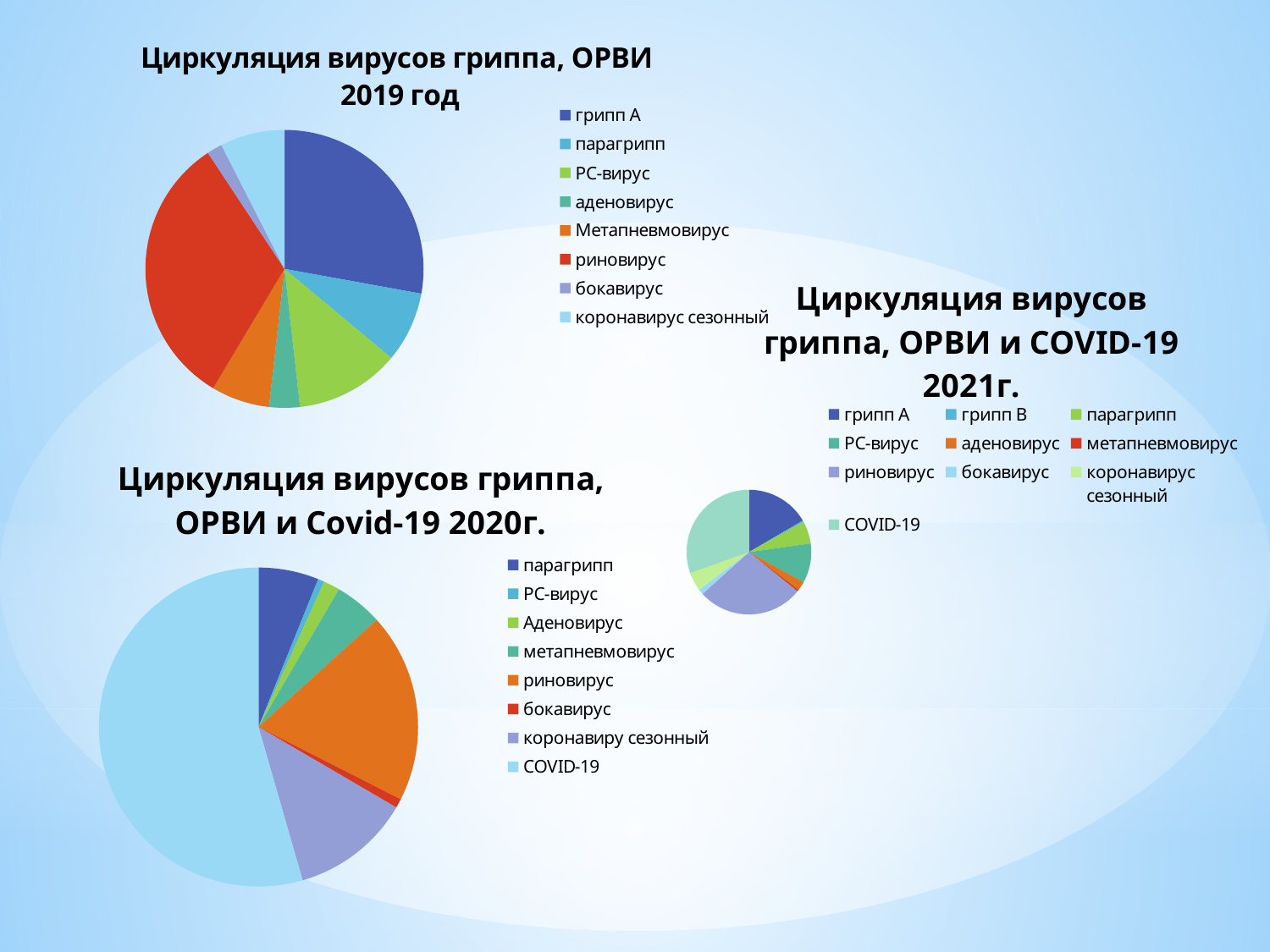
In the 2019 chart, which slice is larger: РС-вирус or Метапневмовирус? РС-вирус In the 2020 chart, which category has the smallest slice? РС-вирус In the 2020 chart ('Циркуляция вирусов гриппа, ОРВИ и Covid-19 2020г.'), which category has the largest slice? COVID-19 How many entries does the legend of the 2020 chart list? 8 In the 2021 chart, which slice is larger: грипп A or парагрипп? грипп A How many entries does the legend of the 2019 chart list? 8 How many entries does the legend of the 2021 chart ('Циркуляция вирусов гриппа, ОРВИ и COVID-19 2021г.') list? 10 In the 2021 chart, which slice is larger: риновирус or аденовирус? риновирус In the 2019 chart, which category has the smallest slice? бокавирус What kind of chart is used in 'Циркуляция вирусов гриппа, ОРВИ 2019 год'? pie chart